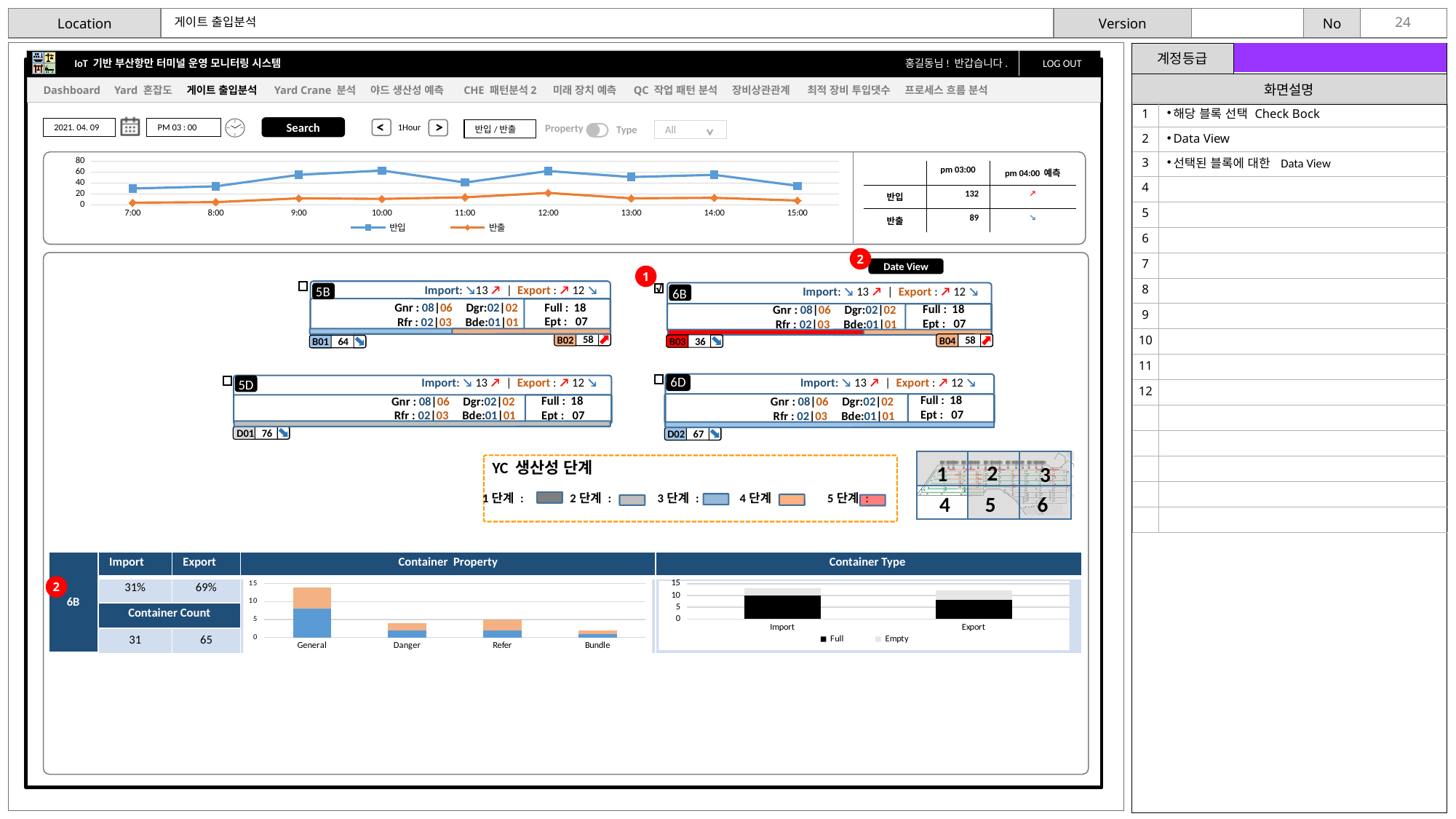
What are the two legend entries of the Container Type chart? Full, Empty In the top line chart, which series is higher at 12:00, 반입 or 반출? 반입 In the Container Property chart, is the total bar height for General greater or less than 10? greater What kind of chart is the top chart showing 반입 and 반출 over time? line chart In the top line chart, is the 반출 value at 7:00 greater or less than 20? less In the top line chart, is the 반입 value at 10:00 greater or less than 40? greater How many time points are plotted along the x axis of the top line chart? 9 What kind of chart is the Container Property chart? bar chart How many series does the legend of the top line chart list? 2 In the Container Property chart, which category has the tallest bar? General How many categories are shown on the x axis of the Container Property chart? 4 In the Container Property chart, which category has the shortest bar? Bundle